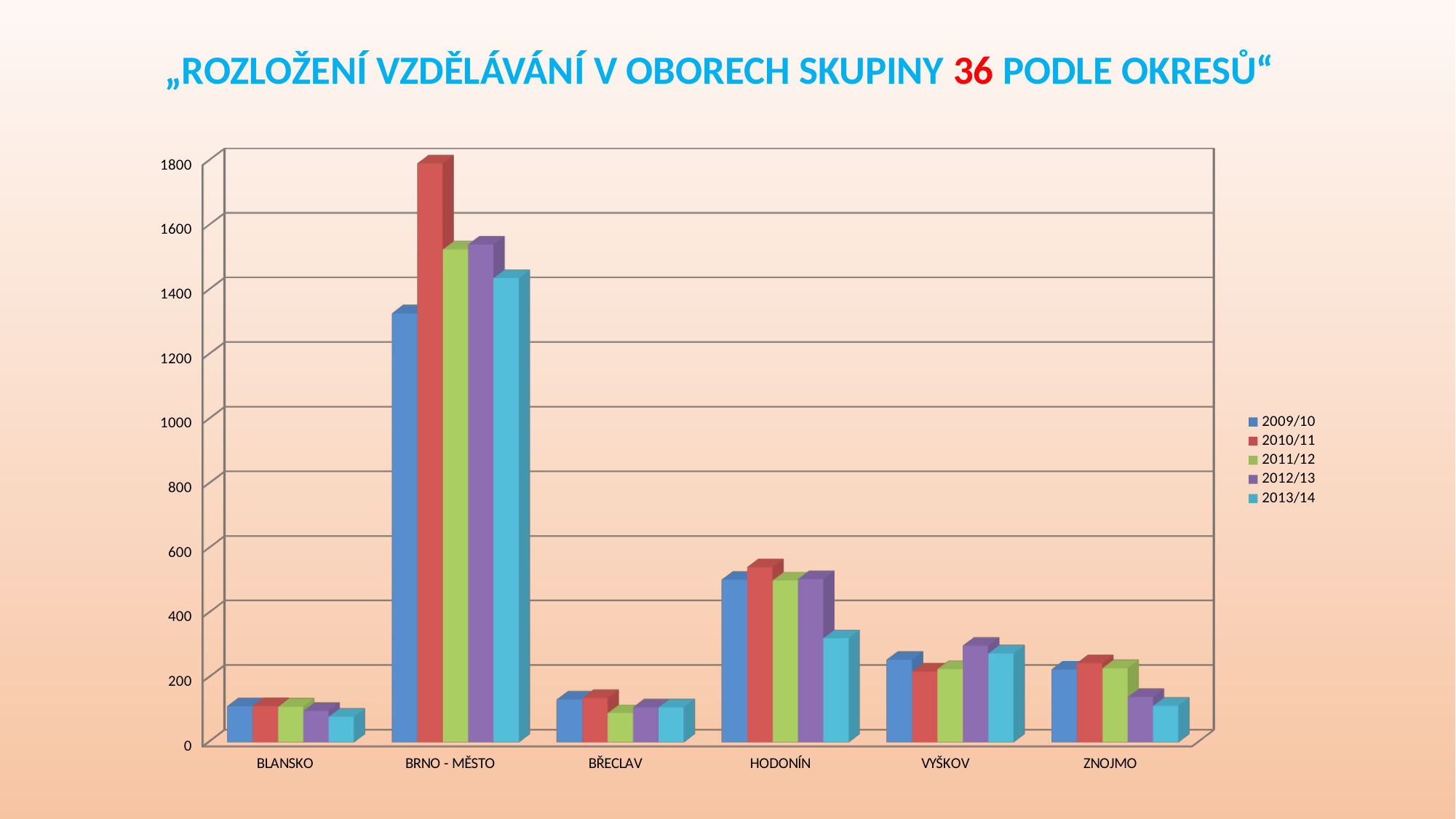
Is the 2010/11 value for BRNO - MĚSTO greater or less than 1600? greater Which is larger for BRNO - MĚSTO: the 2010/11 value or the 2013/14 value? 2010/11 Which is larger: the 2010/11 value for HODONÍN or the 2010/11 value for VYŠKOV? HODONÍN Which series has the highest value for BRNO - MĚSTO? 2010/11 Is the 2009/10 value for BRNO - MĚSTO greater or less than 1200? greater Which series is listed first in the legend? 2009/10 Which district has the highest values overall? BRNO - MĚSTO Is the 2013/14 value for HODONÍN greater or less than 400? less How many series does the legend list? 5 How many districts (categories) are shown on the x axis? 6 What kind of chart is shown on the slide? bar chart